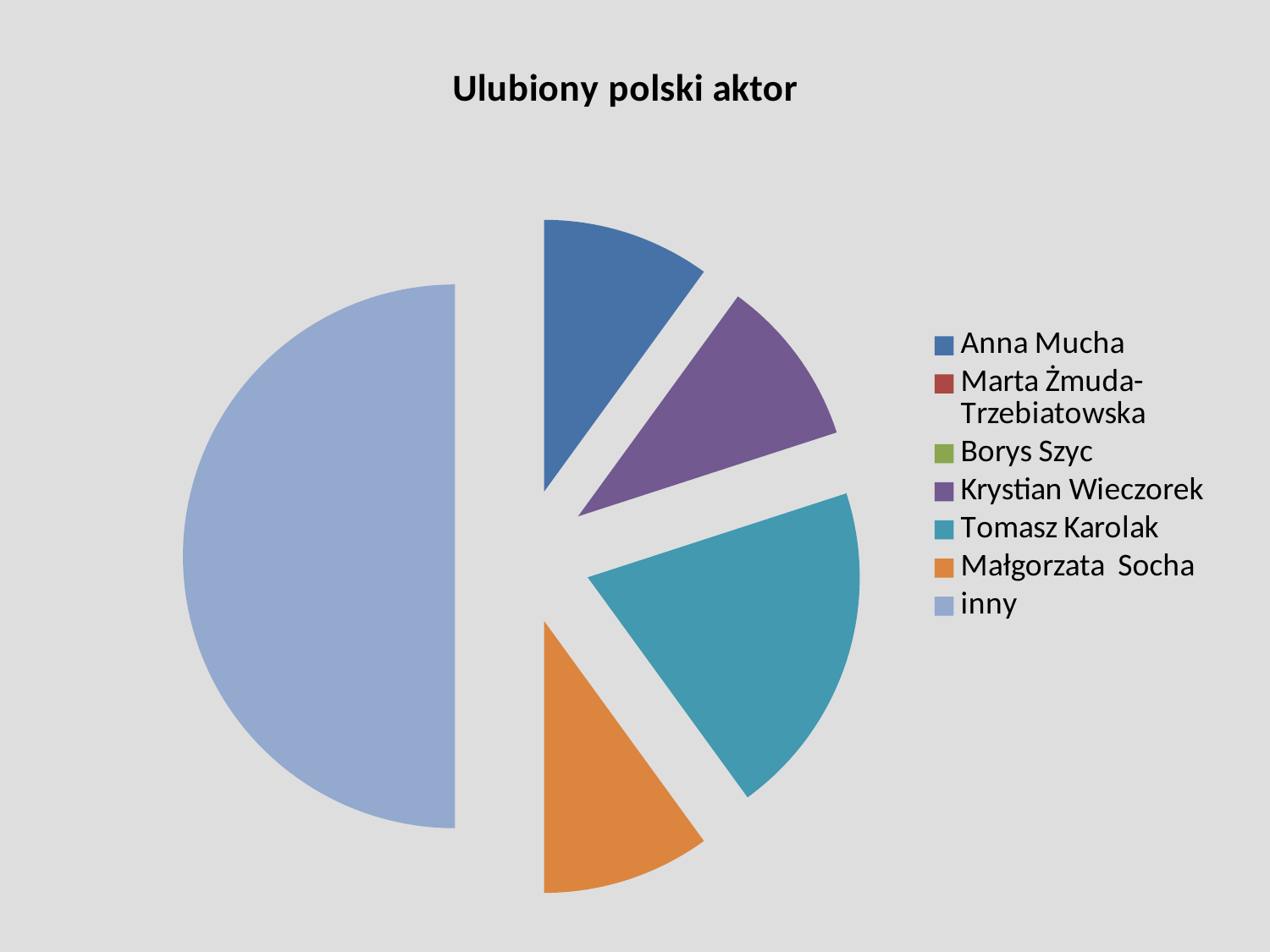
Which slice is larger, inny or Tomasz Karolak? inny What kind of chart is shown on the slide? pie chart Which category is shown in the teal slice of the pie? Tomasz Karolak What is the title of the chart? Ulubiony polski aktor Which slice is larger, Tomasz Karolak or Małgorzata Socha? Tomasz Karolak Which slice is larger, Tomasz Karolak or Anna Mucha? Tomasz Karolak Which category has the largest slice of the pie? inny How many categories does the legend of the chart list? 7